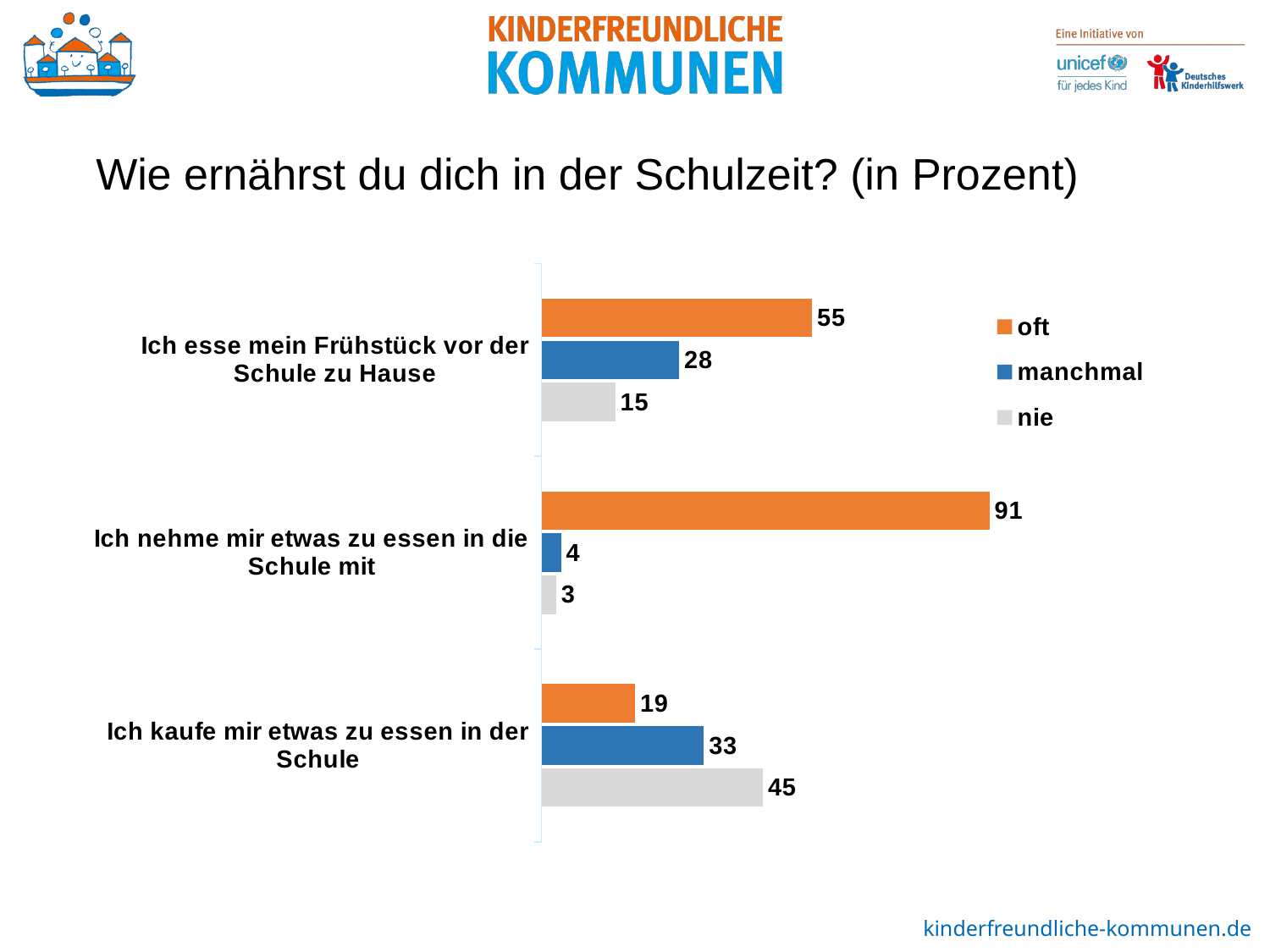
How many categories are shown on the chart? 3 How many series does the legend list? 3 Which category has the highest value for "oft"? Ich nehme mir etwas zu essen in die Schule mit What is the value for "nie" for "Ich nehme mir etwas zu essen in die Schule mit"? 3 What is the value for "oft" for "Ich esse mein Frühstück vor der Schule zu Hause"? 55 What is the title of the slide's chart? Wie ernährst du dich in der Schulzeit? (in Prozent) Which colour represents the "manchmal" series in the legend? blue What is the value for "manchmal" for "Ich kaufe mir etwas zu essen in der Schule"? 33 Which category has the lowest value for "nie"? Ich nehme mir etwas zu essen in die Schule mit What kind of chart is shown on the slide? bar chart Which is larger for "Ich kaufe mir etwas zu essen in der Schule": the "oft" value or the "nie" value? nie What is the difference between the "oft" and "manchmal" values for "Ich esse mein Frühstück vor der Schule zu Hause"? 27